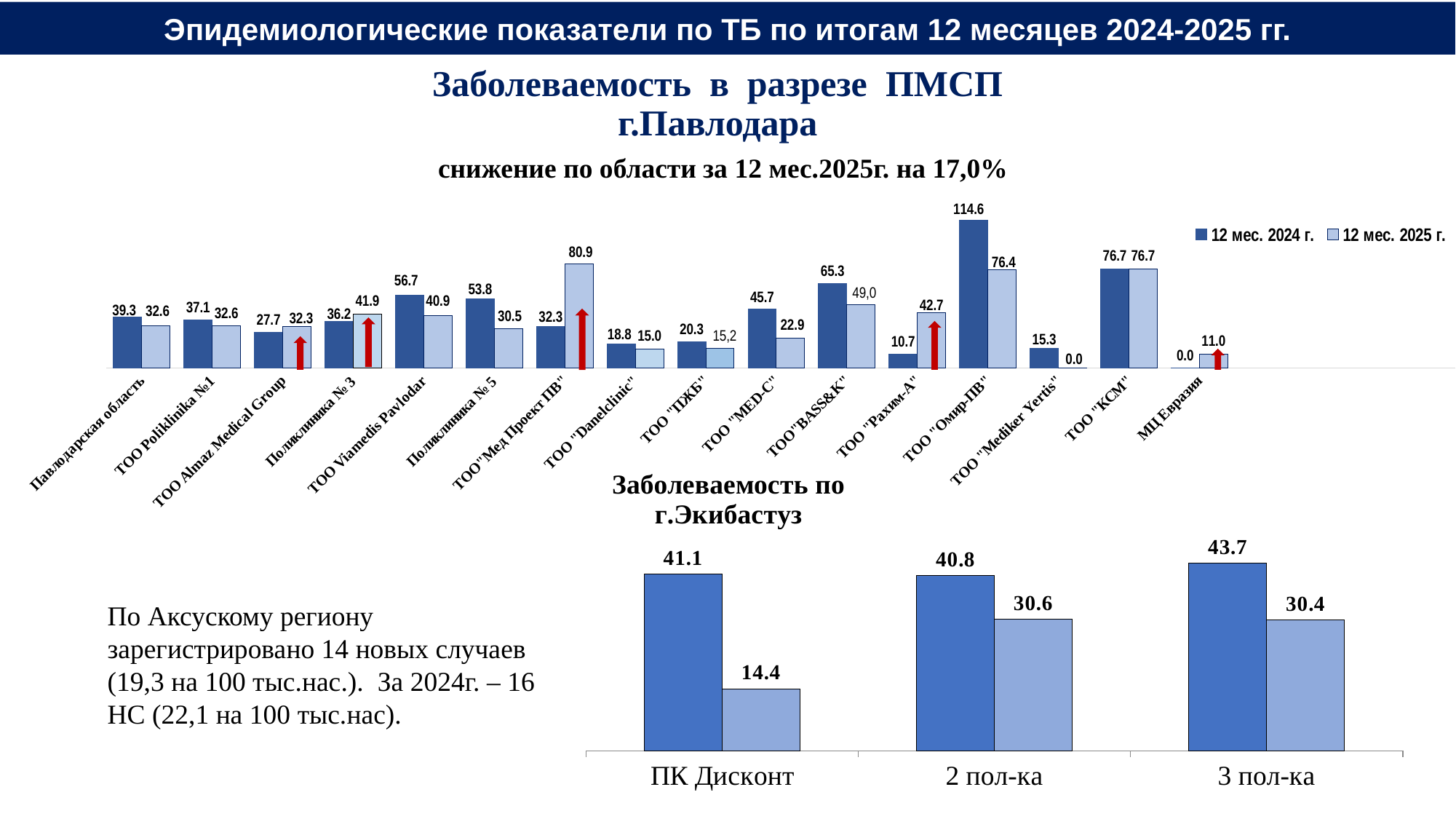
In the chart 'Заболеваемость по г.Экибастуз', which category has the highest value for the left (darker) bar? 3 пол-ка In the chart 'Заболеваемость в разрезе ПМСП г.Павлодара', what is the value for ТОО "Мед Проект ПВ" for 12 мес. 2025 г.? 80.9 In the chart 'Заболеваемость в разрезе ПМСП г.Павлодара', what is the difference between the 12 мес. 2024 г. and 12 мес. 2025 г. values for ТОО "MED-C"? 22.8 What kind of chart is 'Заболеваемость по г.Экибастуз'? Bar chart In the chart 'Заболеваемость в разрезе ПМСП г.Павлодара', which is larger for Поликлиника № 3: the 12 мес. 2024 г. value or the 12 мес. 2025 г. value? 12 мес. 2025 г. In the chart 'Заболеваемость по г.Экибастуз', what is the value of the right (lighter) bar for ПК Дисконт? 14.4 In the chart 'Заболеваемость по г.Экибастуз', what is the difference between the two bars for 2 пол-ка? 10.2 How many series does the legend of the chart 'Заболеваемость в разрезе ПМСП г.Павлодара' list? 2 In the chart 'Заболеваемость в разрезе ПМСП г.Павлодара', which category has the lowest value for 12 мес. 2025 г.? ТОО "Mediker Yertis" In the chart 'Заболеваемость в разрезе ПМСП г.Павлодара', what is the value for ТОО "Омир-ПВ" for 12 мес. 2024 г.? 114.6 In the chart 'Заболеваемость в разрезе ПМСП г.Павлодара', which category has the highest value for 12 мес. 2024 г.? ТОО "Омир-ПВ" How many categories are shown in the chart 'Заболеваемость в разрезе ПМСП г.Павлодара'? 16